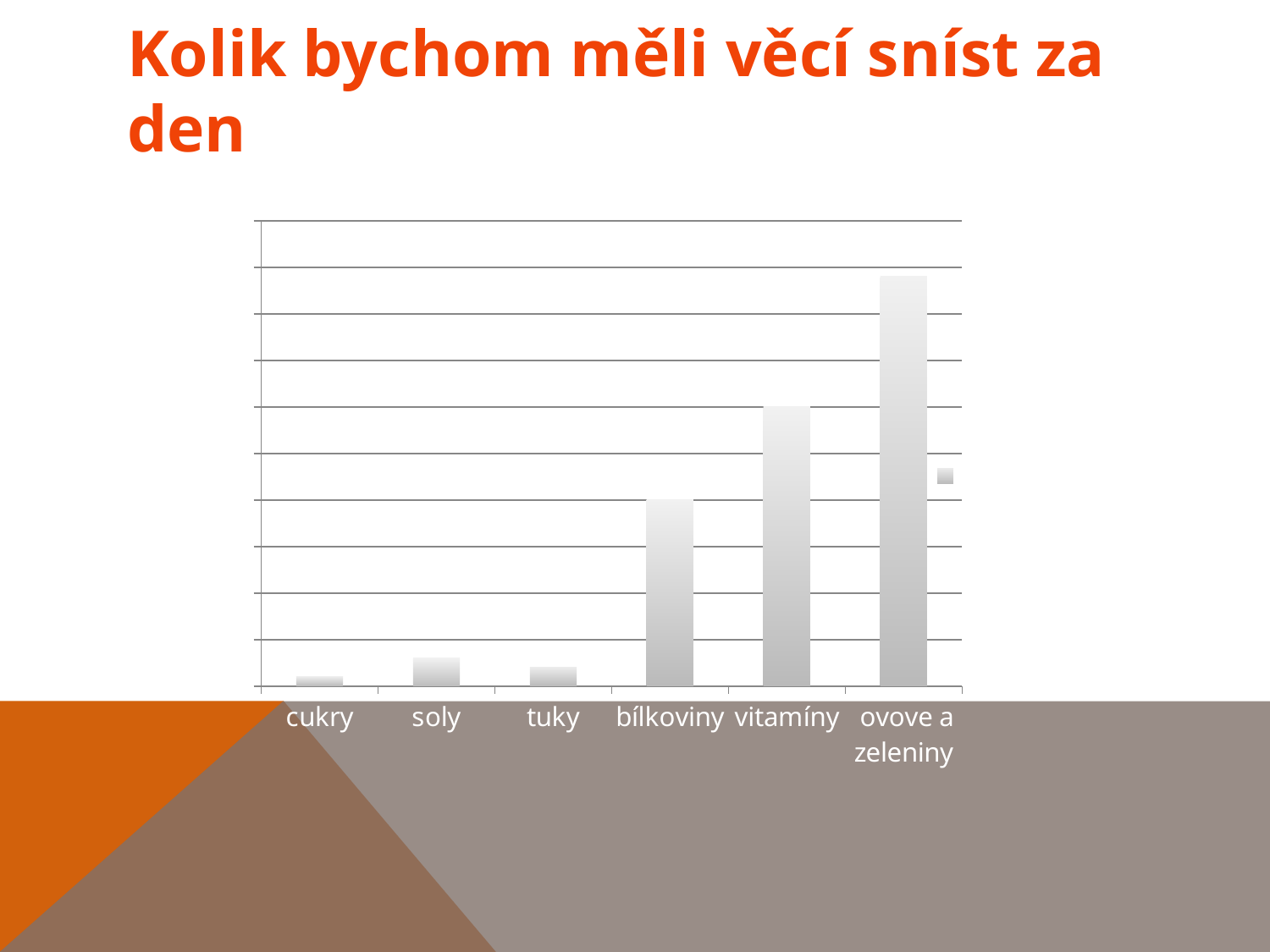
Which category has the highest bar in the chart? ovove a zeleniny How many categories are shown on the x axis of the chart? 6 Which category has the lowest bar in the chart? cukry Which is larger, the bar for tuky or the bar for vitamíny? vitamíny What is the label of the first category on the x axis of the chart? cukry Do the bar values generally rise or fall from left to right across the x axis? rise Which is larger, the bar for vitamíny or the bar for ovove a zeleniny? ovove a zeleniny What is the title of the slide containing the chart? Kolik bychom měli věcí sníst za den What kind of chart is shown on the slide? bar chart Which is larger, the bar for cukry or the bar for bílkoviny? bílkoviny